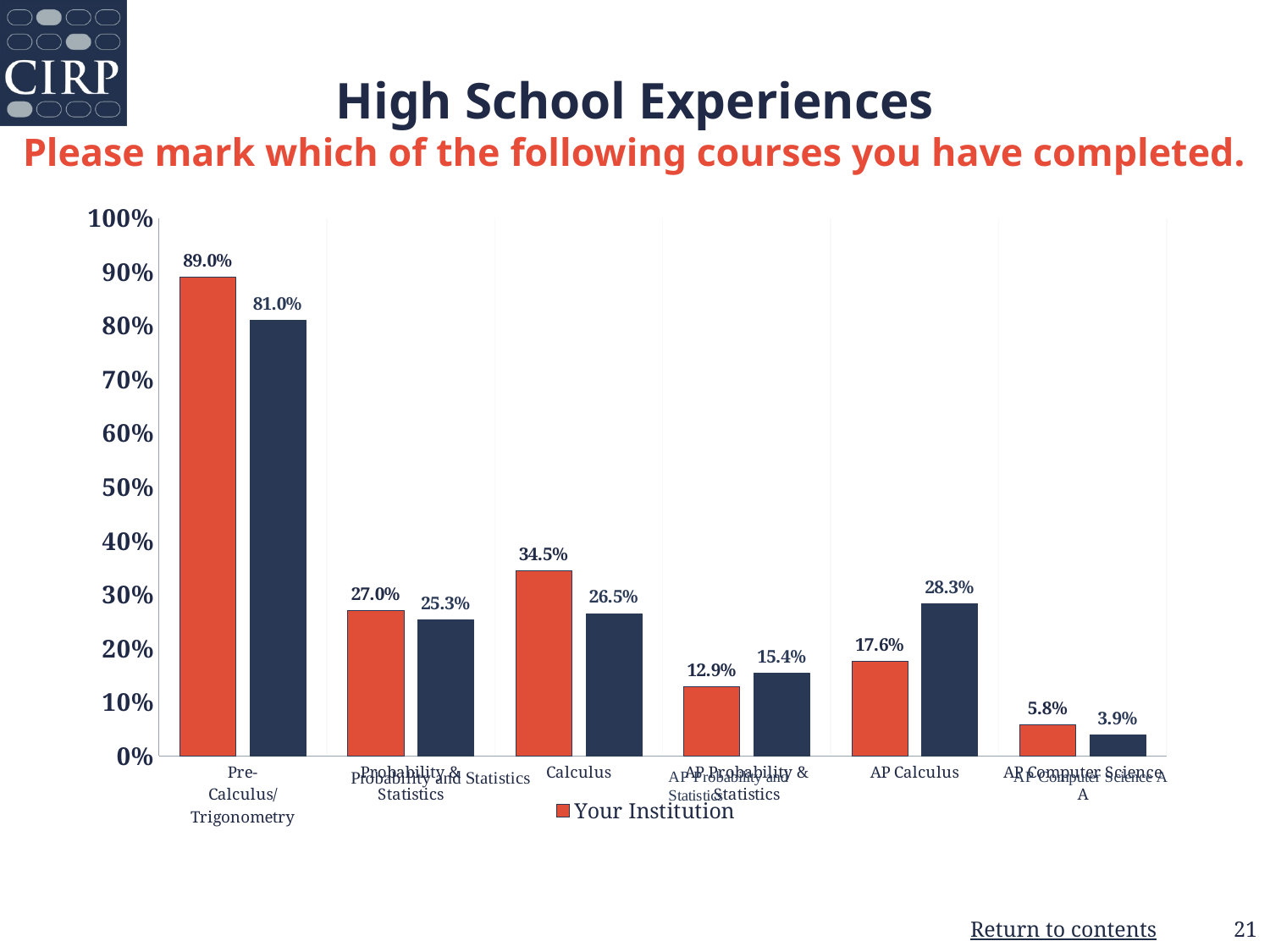
How many courses are shown on the x axis? 6 What is the value of the dark blue bar for AP Computer Science A? 3.9% What is the Your Institution value for Calculus? 34.5% Which course has the highest Your Institution value? Pre-Calculus/Trigonometry For Pre-Calculus/Trigonometry, how much higher is the Your Institution value (89.0%) than the dark blue bar (81.0%)? 8.0 percentage points Is the Your Institution value for Probability & Statistics greater or less than 30%? less For AP Calculus, which is larger: the Your Institution bar or the dark blue bar? The dark blue bar (28.3%) What is the title of the slide? High School Experiences Which course has the lowest Your Institution value? AP Computer Science A What is the Your Institution value for AP Calculus? 17.6% What is the Your Institution value for AP Probability & Statistics? 12.9% What kind of chart is shown on the slide? Bar chart